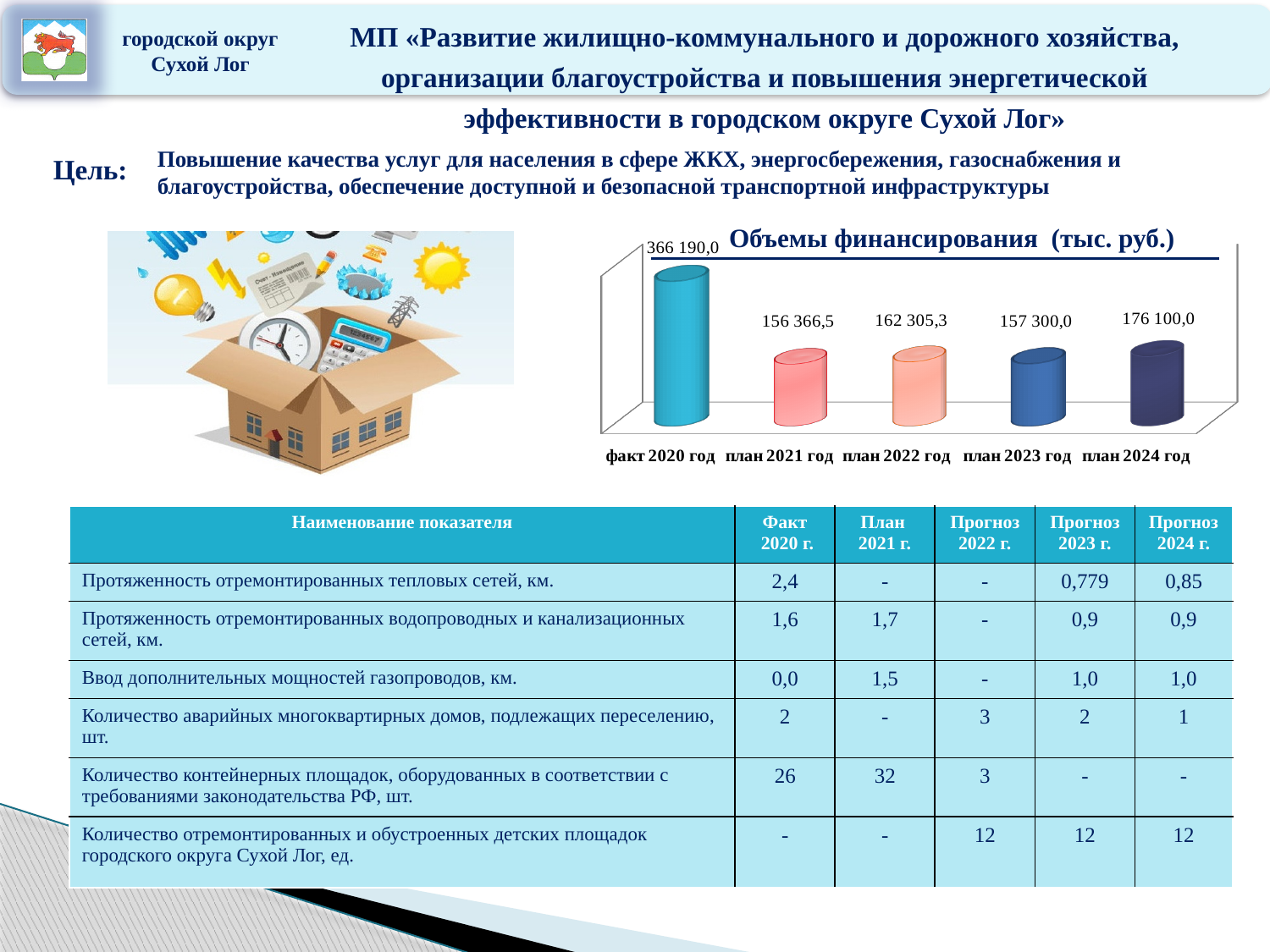
What kind of chart is the Объемы финансирования chart? bar chart What is the difference between факт 2020 год and план 2021 год in the Объемы финансирования chart? 209 823,5 What is the value for план 2021 год in the Объемы финансирования chart? 156 366,5 Which category has the lowest value in the Объемы финансирования chart? план 2021 год Which is larger in the Объемы финансирования chart: план 2022 год or план 2023 год? план 2022 год What is the value for план 2024 год in the Объемы финансирования chart? 176 100,0 What is the difference between план 2024 год and план 2023 год in the Объемы финансирования chart? 18 800,0 What is the value for план 2022 год in the Объемы финансирования chart? 162 305,3 What unit is given in the title of the chart on the slide? тыс. руб. Which category has the highest value in the Объемы финансирования chart? факт 2020 год What is the value for факт 2020 год in the Объемы финансирования chart? 366 190,0 How many categories are shown in the Объемы финансирования chart? 5